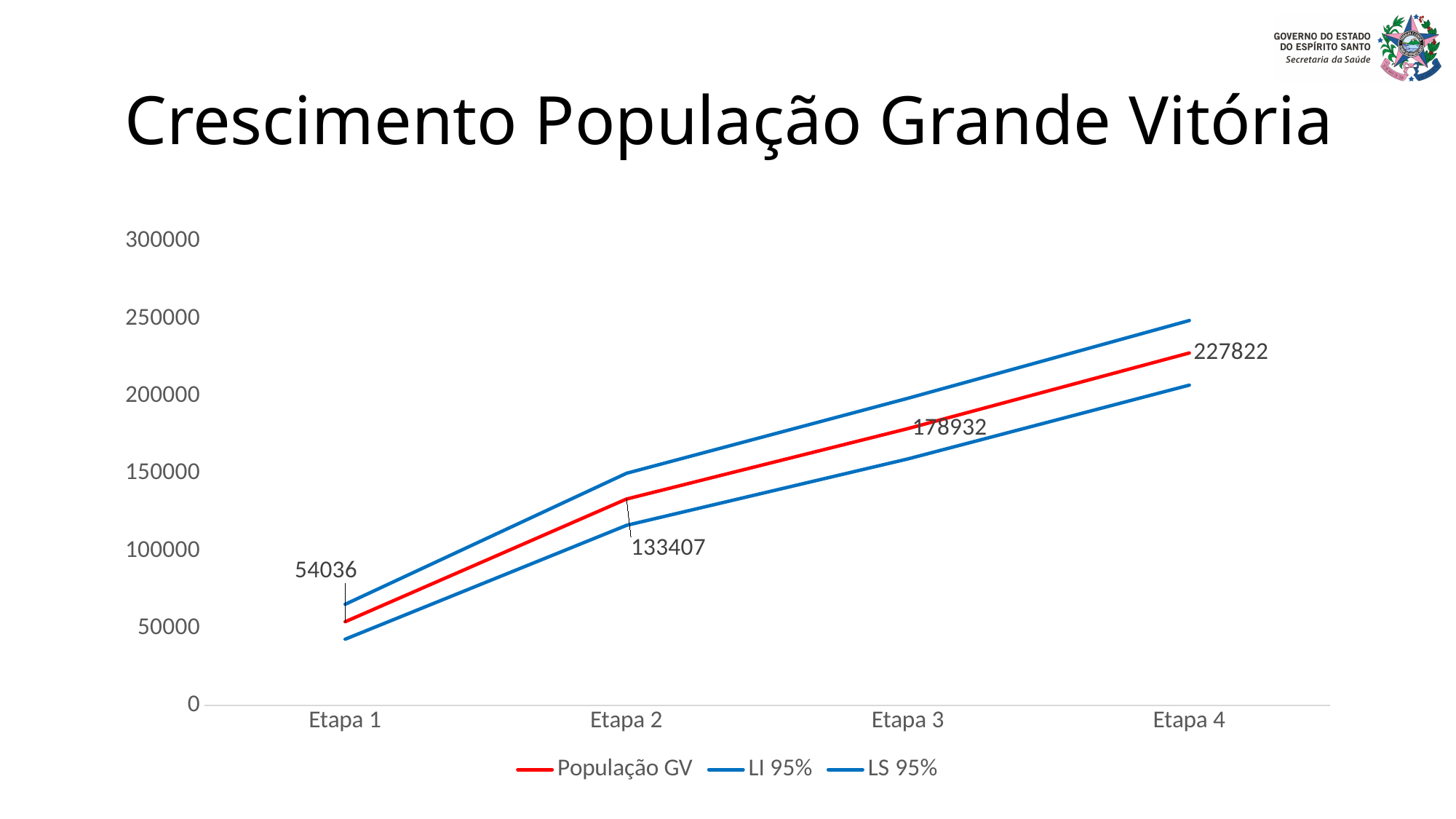
Is the value of LI 95% at Etapa 1 greater or less than 50000? less What is the value of População GV at Etapa 2? 133407 What is the difference between População GV at Etapa 4 and at Etapa 1? 173786 What is the value of População GV at Etapa 1? 54036 What is the value of População GV at Etapa 3? 178932 What kind of chart is shown on the slide? Line chart What is the value of População GV at Etapa 4? 227822 Is the value of LS 95% at Etapa 4 greater or less than 200000? greater How many series does the legend list? 3 What is the difference between População GV at Etapa 2 and at Etapa 1? 79371 At which Etapa is População GV highest? Etapa 4 At which Etapa is População GV lowest? Etapa 1